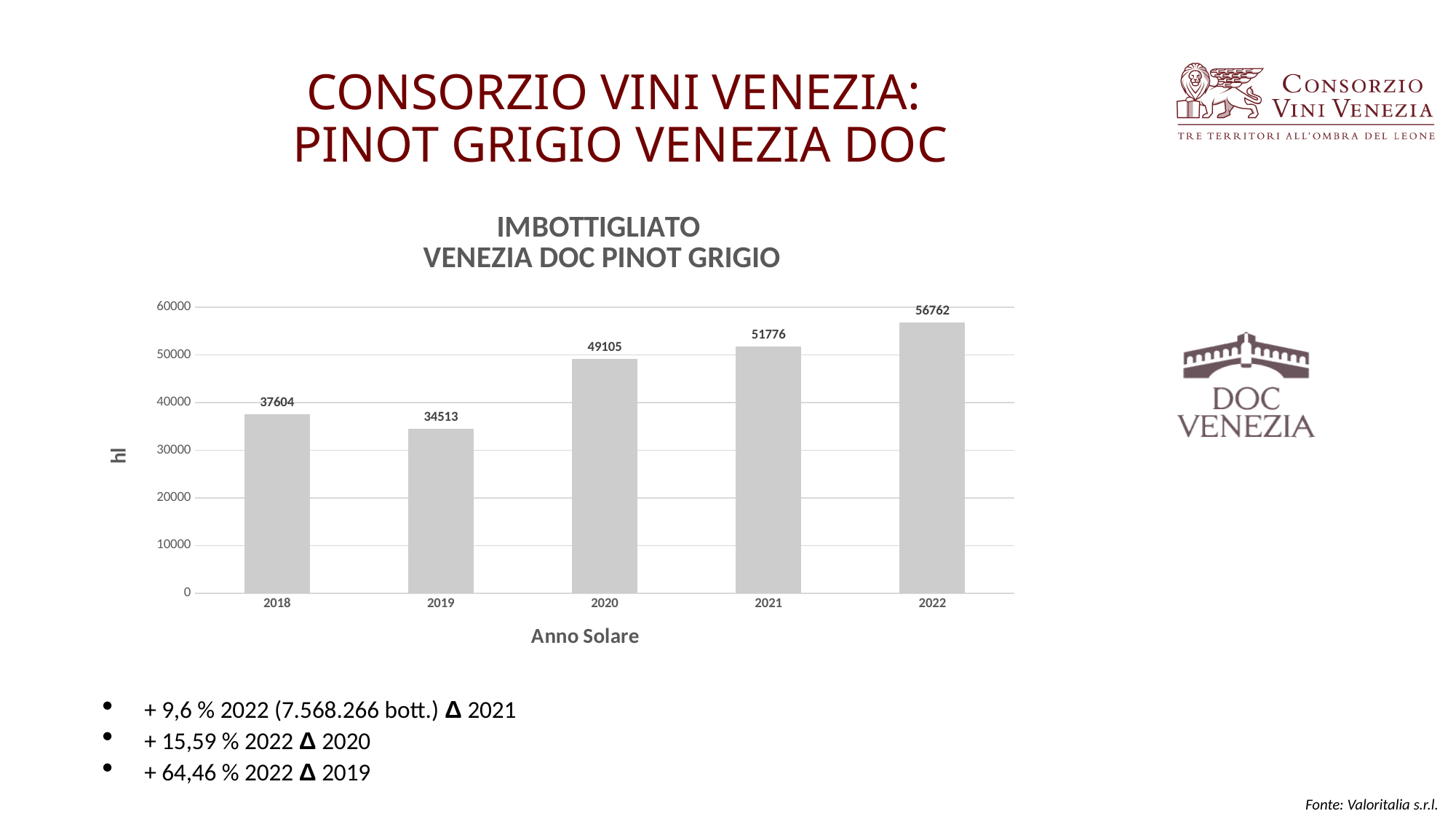
What is the value for 2018? 37604 What kind of chart is shown on the slide? bar chart Is the value for 2019 greater or less than 40000? less How many years are shown on the x axis? 5 What is the difference between the values for 2022 and 2021? 4986 Which is larger, the value for 2020 or the value for 2021? 2021 What is the label of the x axis? Anno Solare Which year has the highest value? 2022 What is the value for 2020? 49105 What is the difference between the values for 2018 and 2019? 3091 What is the value for 2022? 56762 Which year has the lowest value? 2019